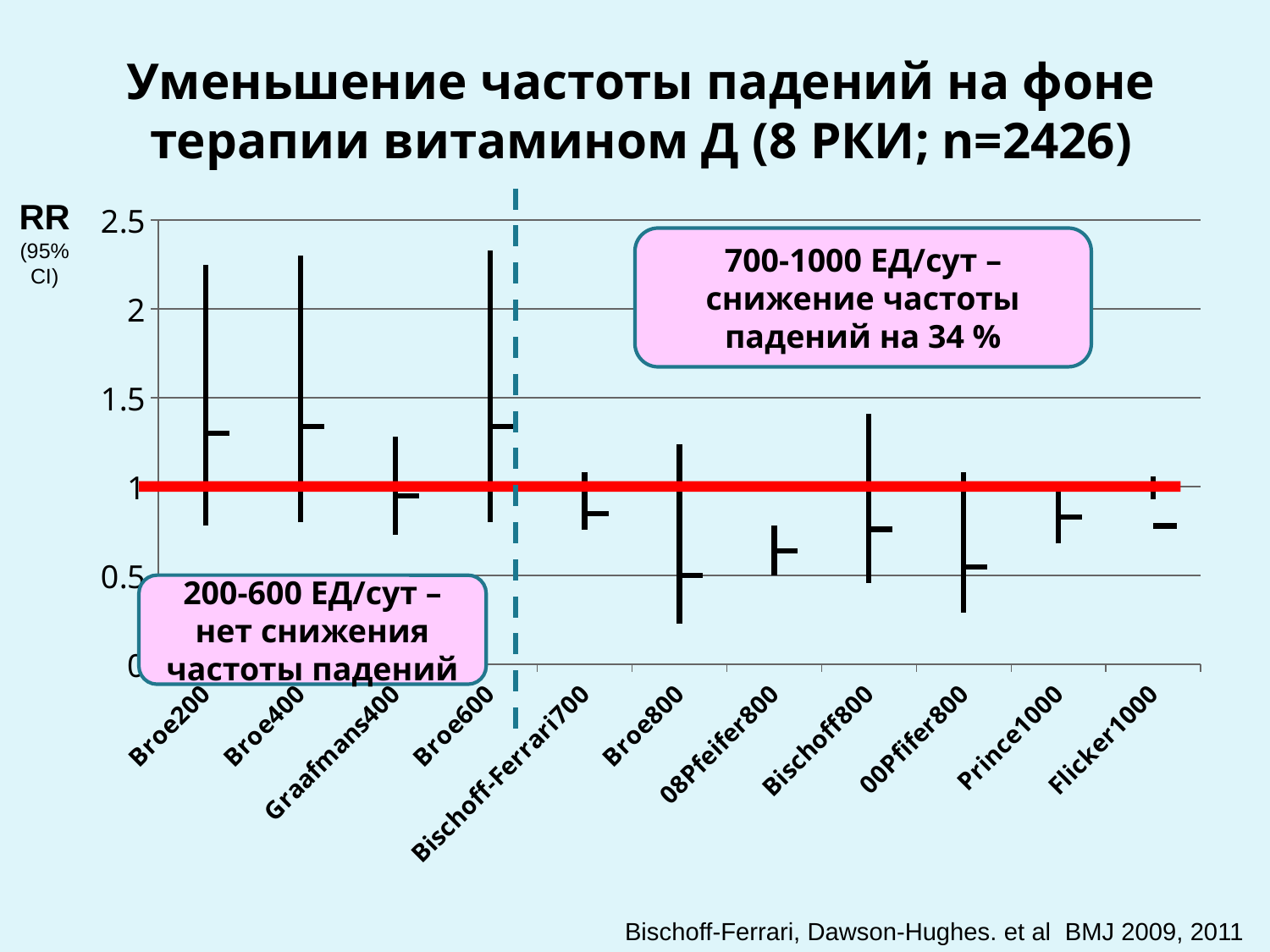
At what y-axis value is the horizontal red reference line drawn? 1 Is the RR point estimate for Broe600 greater or less than 1? greater Is the upper end of the confidence interval for Broe200 greater or less than 2? greater Is the RR point estimate for Broe200 greater or less than 1? greater How many studies (categories) are plotted along the x axis? 11 Which has the larger RR point estimate, Broe400 or Bischoff800? Broe400 Which has the larger RR point estimate, Broe200 or 08Pfeifer800? Broe200 What is the label of the y axis? RR (95% CI)